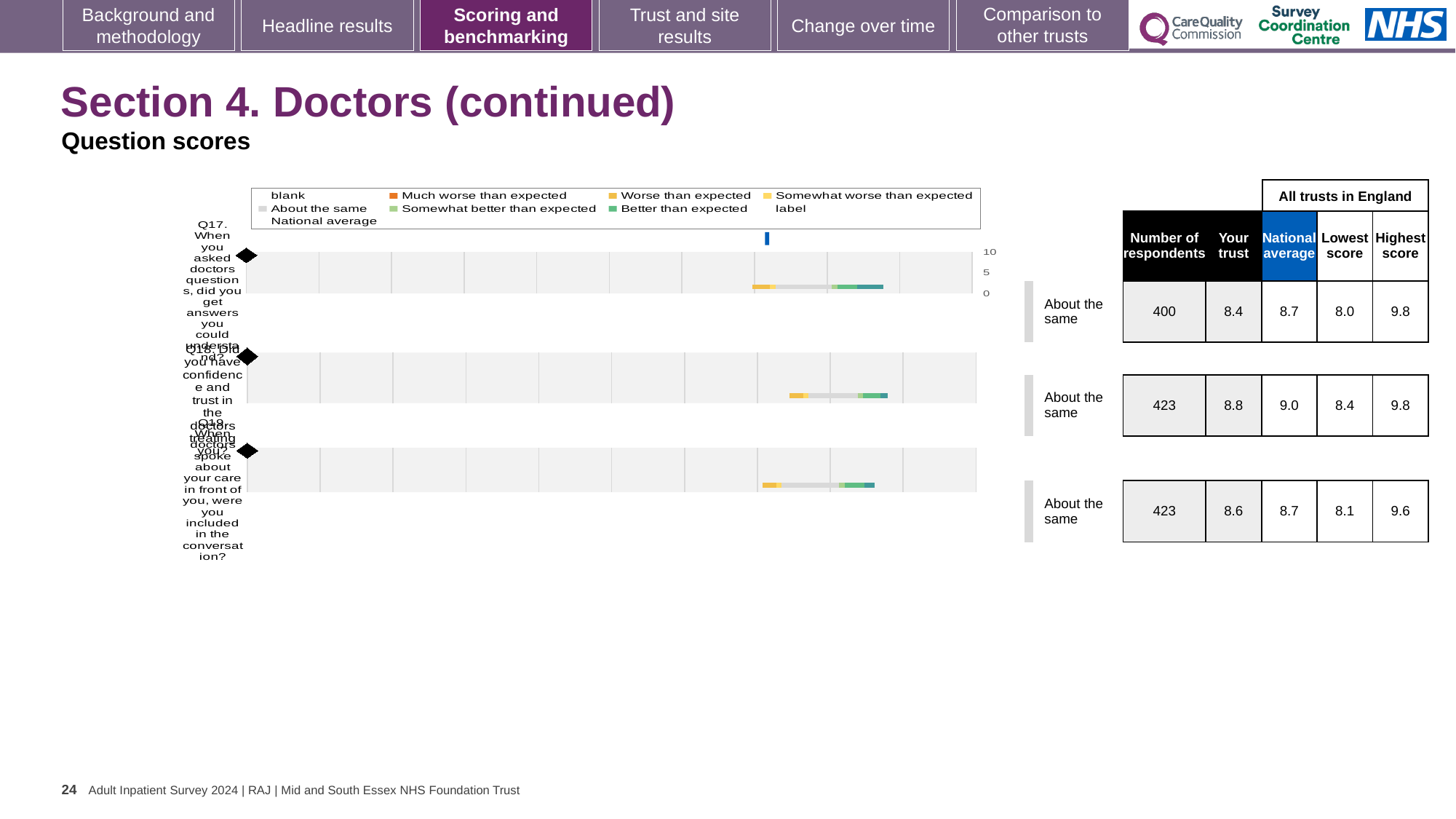
What kind of chart is shown on the slide? bar chart How many questions (categories) are plotted in the chart? 3 Which question has the highest 'Your trust' score? Q18 What colour does the legend use for 'Much worse than expected'? Orange How many respondents are listed for Q19? 423 What is the highest score across all trusts in England for Q19? 9.6 What is the lowest score across all trusts in England for Q18? 8.4 What is the 'Your trust' score for Q17? 8.4 What is the national average score for Q18? 9.0 What benchmark category is shown for Q17? About the same For Q17, which is larger: the 'Your trust' score or the national average? National average What is the difference between the national average and the 'Your trust' score for Q18? 0.2